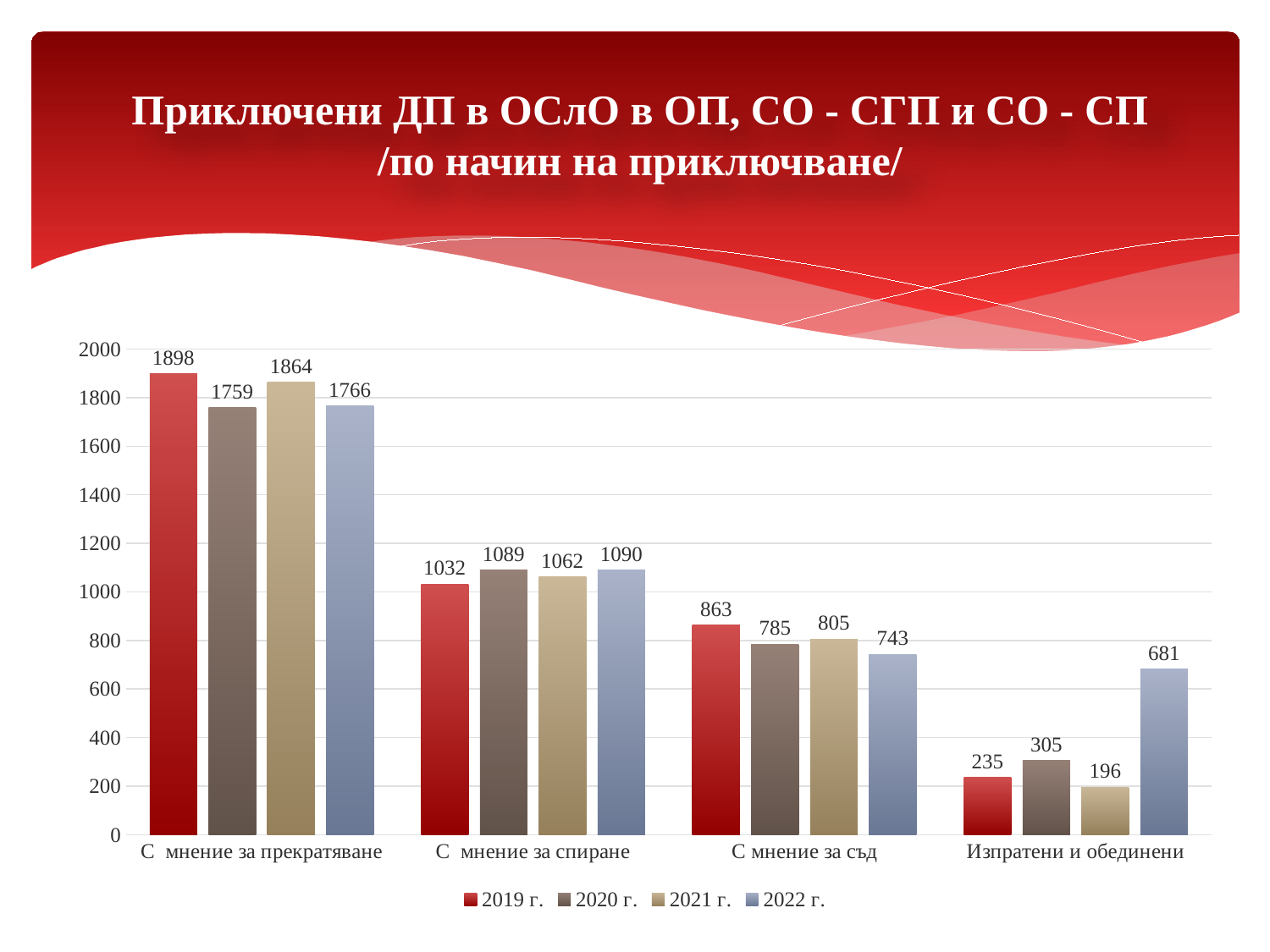
Which year has the highest value in the category "С мнение за съд"? 2019 г. What kind of chart is shown on the slide? bar chart What is the difference between the 2019 г. and 2020 г. values in the category "С мнение за прекратяване"? 139 Is the value for 2020 г. in the category "Изпратени и обединени" greater or less than 400? less What is the value for 2021 г. in the category "С мнение за спиране"? 1062 What is the value for 2019 г. in the category "С мнение за прекратяване"? 1898 What colour are the bars for 2022 г.? blue Which year has the lowest value in the category "Изпратени и обединени"? 2021 г. What is the value for 2022 г. in the category "Изпратени и обединени"? 681 How many series does the legend list? 4 How many categories are shown on the x axis? 4 Which is larger in the category "С мнение за съд": the value for 2021 г. or the value for 2022 г.? 2021 г.